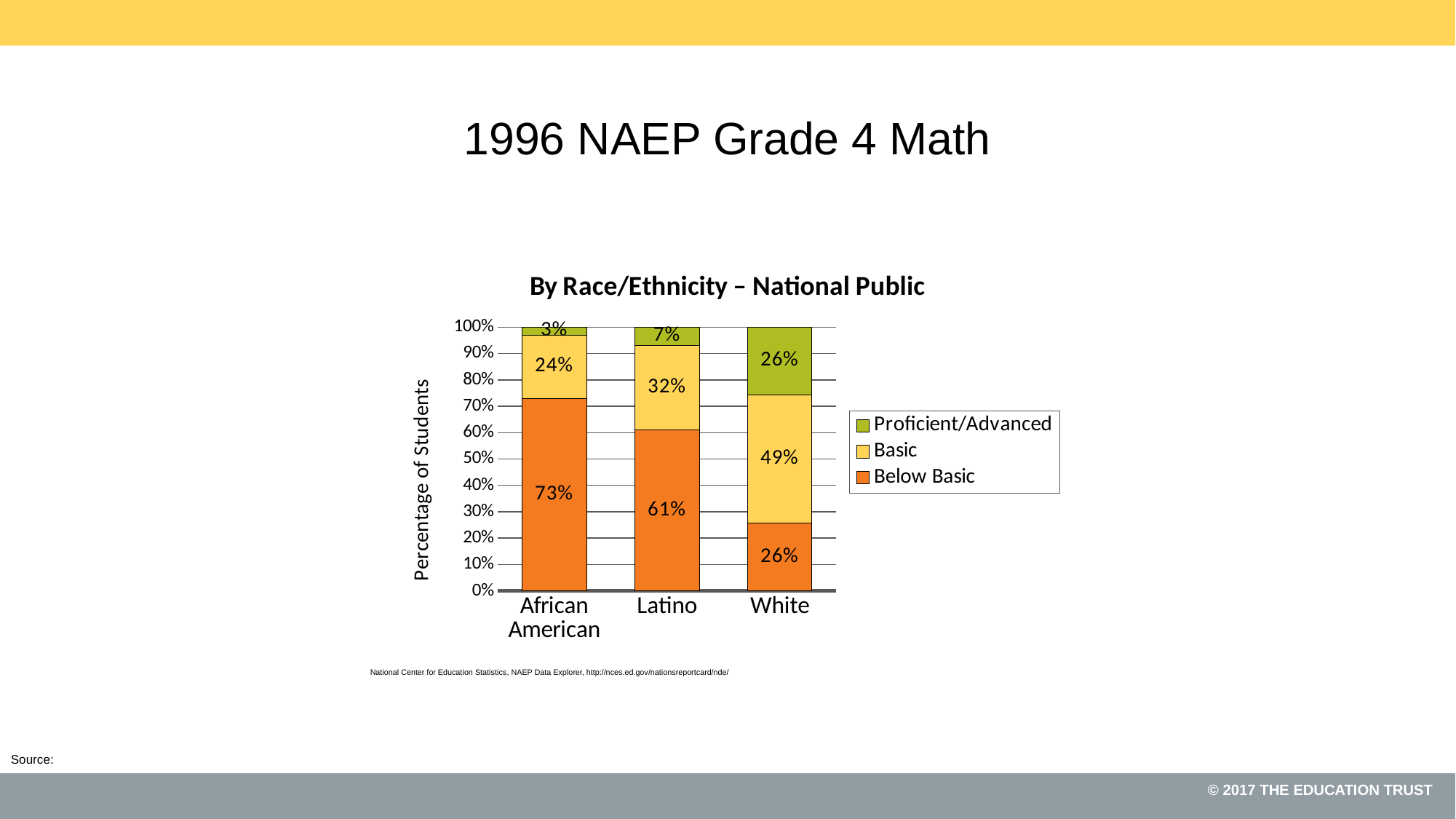
Which is larger: the Basic percentage for Latino students or for African American students? Latino Which group has the highest Below Basic percentage? African American What is the title of the chart? By Race/Ethnicity – National Public How many race/ethnicity groups are shown on the x axis? 3 What percentage of African American students scored Below Basic? 73% What percentage of White students scored Proficient/Advanced? 26% What kind of chart is shown on the slide? Stacked bar chart What is the total of the stacked bar for Latino students? 100% How many series does the legend list? 3 What percentage of Latino students scored Basic? 32% What is the difference between the Below Basic percentages for African American and White students? 47% Which group has the lowest Proficient/Advanced percentage? African American